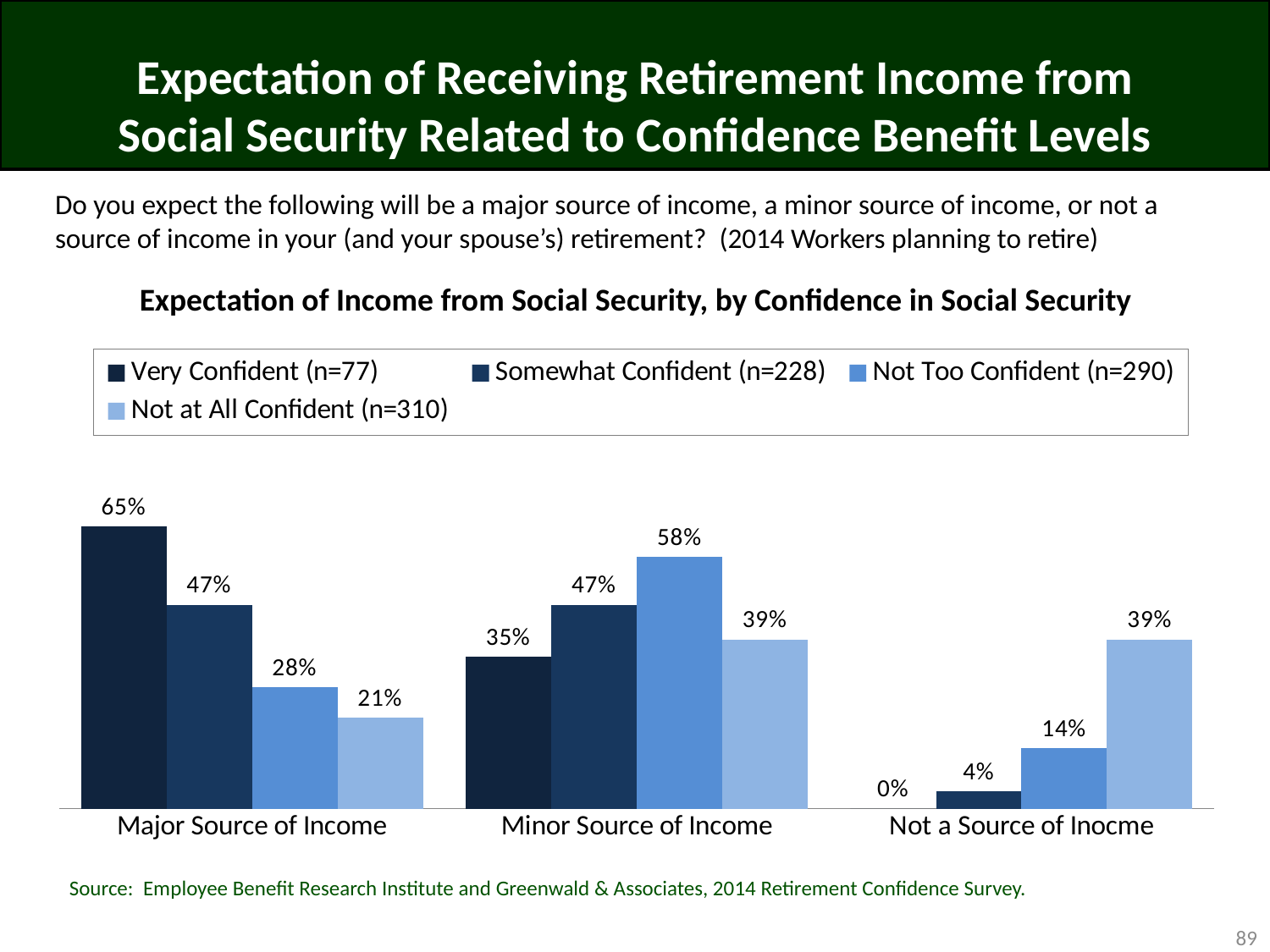
How many categories are shown on the x axis? 3 Which confidence group has the lowest value in the Not a Source of Inocme category? Very Confident (n=77) How many series does the legend list? 4 What is the difference between the Very Confident and Not at All Confident values in the Major Source of Income category? 44 percentage points In the Minor Source of Income category, which is larger: the Very Confident value or the Somewhat Confident value? Somewhat Confident What percentage of Very Confident workers expect Social Security to be a major source of income? 65% What is the value for Not Too Confident workers in the Minor Source of Income category? 58% Do the values for the Very Confident series rise or fall across the categories from left to right? Fall What kind of chart is shown on the slide? Bar chart Which confidence group has the highest value in the Major Source of Income category? Very Confident (n=77) What is the sample size (n) for the Not Too Confident group shown in the legend? 290 What is the value for Not at All Confident workers in the Not a Source of Inocme category? 39%